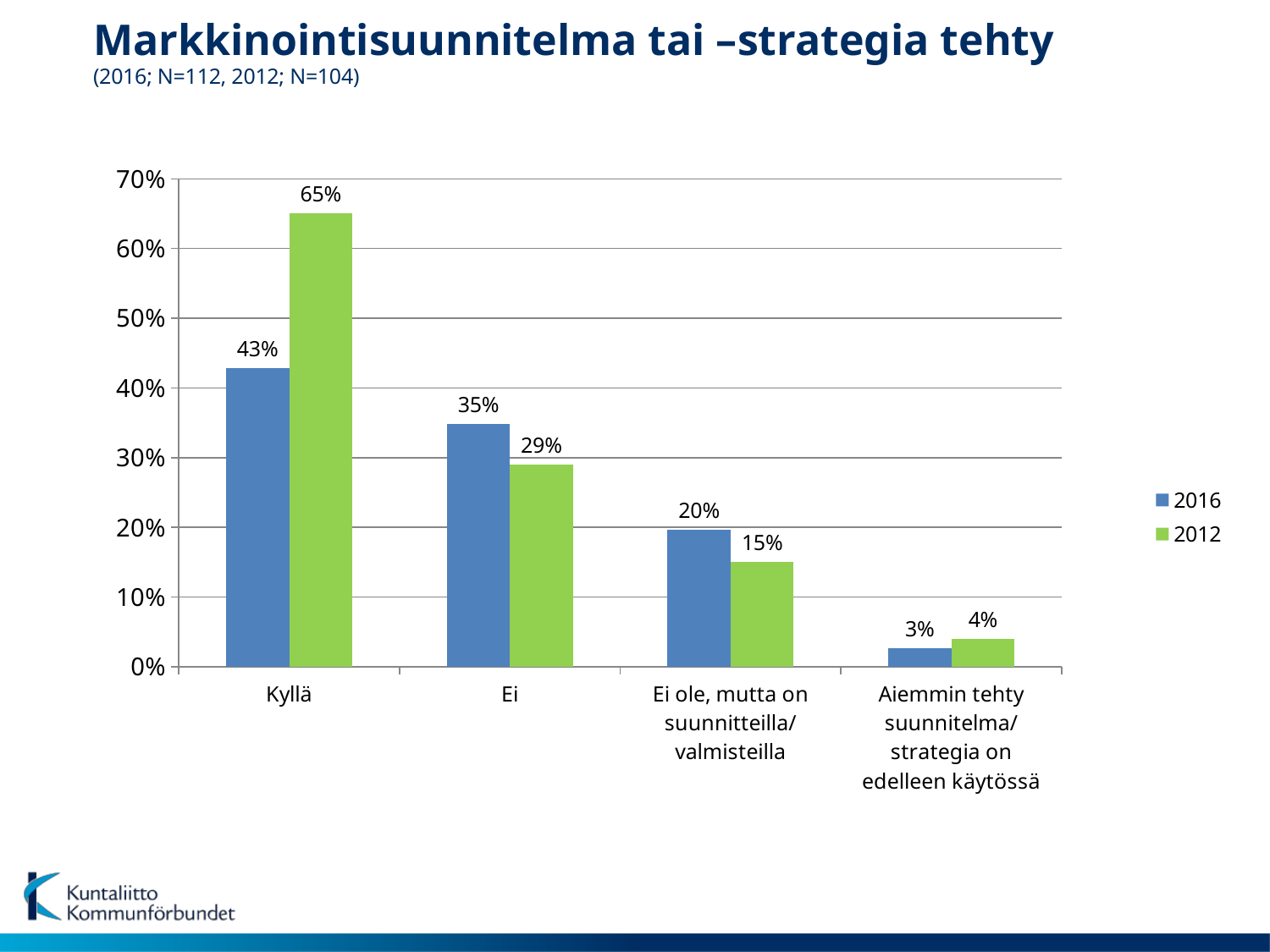
Which colour represents the 2012 series? Green What is the 2016 value for 'Ei ole, mutta on suunnitteilla/valmisteilla'? 20% What kind of chart is shown on the slide? Bar chart What is the value for Kyllä in the 2016 series? 43% Which category has the highest value in the 2012 series? Kyllä How many categories are shown on the x axis? 4 Which category has the lowest value in the 2016 series? Aiemmin tehty suunnitelma/strategia on edelleen käytössä What is the value for Kyllä in the 2012 series? 65% How many series does the legend list? 2 For Ei, which series has the larger value, 2016 or 2012? 2016 What is the difference between the 2012 and 2016 values for Kyllä? 22% What is the value for Ei in the 2012 series? 29%